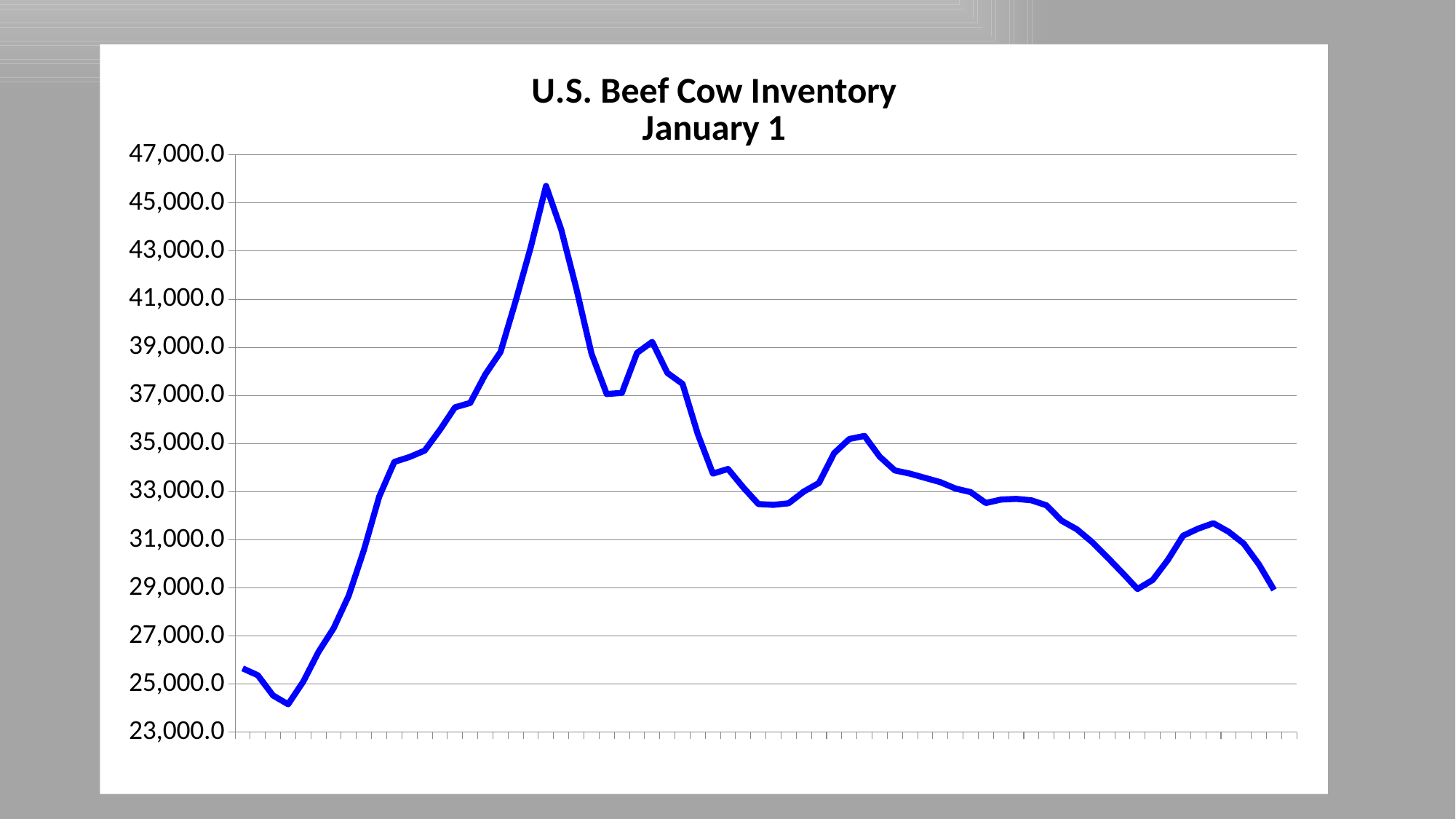
Is the first point on the line greater or less than 25,000.0? greater Is the last point on the line greater or less than 31,000.0? less How many lines are plotted on the chart? 1 What is the title of the chart? U.S. Beef Cow Inventory January 1 Does the line rise or fall from its peak to the right end of the chart? fall Is the lowest point on the line greater or less than 25,000.0? less What is the highest value shown on the vertical axis? 47,000.0 What kind of chart is shown on the slide? line chart Does the line rise or fall from its lowest point to its peak? rise Which is larger, the first point on the line or the last point on the line? the last point